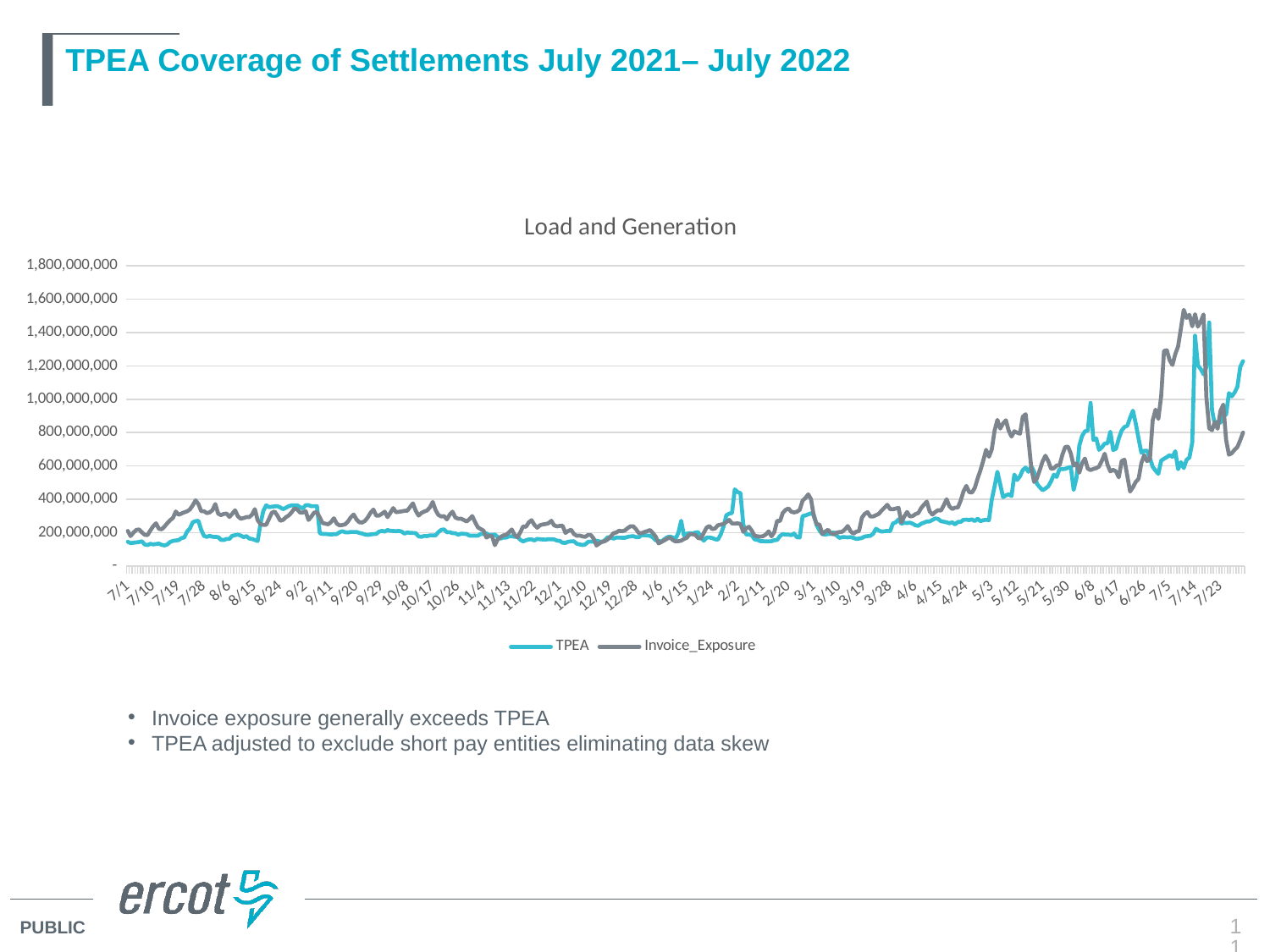
How many series does the chart's legend list? 2 What are the names of the two series in the legend? TPEA and Invoice_Exposure Around 7/28, which series has the higher value, TPEA or Invoice_Exposure? Invoice_Exposure Is the Invoice_Exposure value around 5/3 greater or less than 600,000,000? greater Around 6/8, which series has the higher value, TPEA or Invoice_Exposure? TPEA What is the title of the chart? Load and Generation What is the highest value shown on the y axis? 1,800,000,000 What kind of chart is shown on the slide? Line chart Is the TPEA value at 7/1 greater or less than 200,000,000? less Is the Invoice_Exposure value at 7/1 greater or less than 400,000,000? less Overall, do the values of both series rise or fall from 7/1 to 7/23 along the x axis? rise